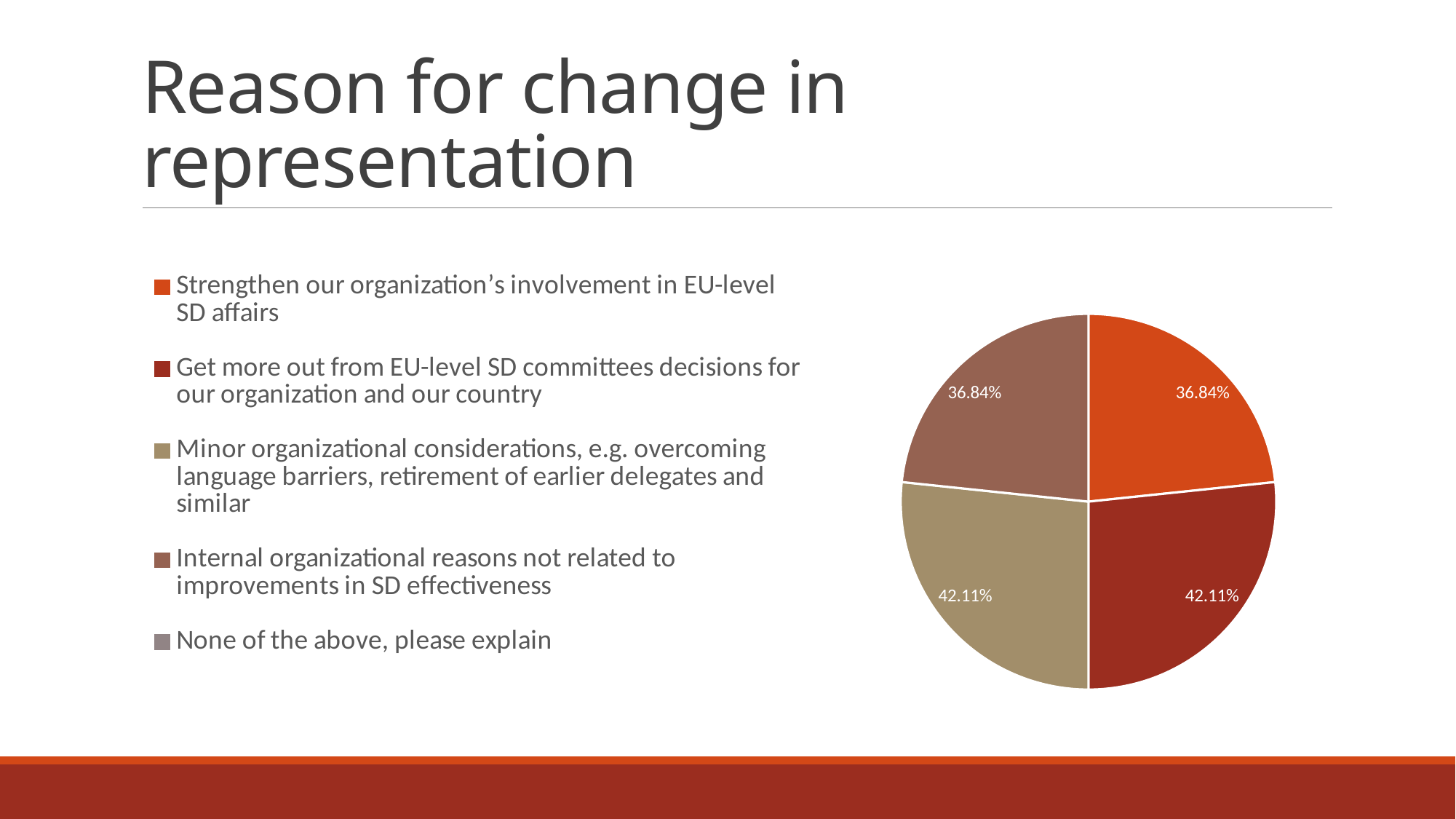
Which is larger: the value for "Get more out from EU-level SD committees decisions" or the value for "Strengthen our organization's involvement in EU-level SD affairs"? Get more out from EU-level SD committees decisions What is the title of the slide containing the pie chart? Reason for change in representation How many slices are visible in the pie chart? 4 How many entries does the legend list? 5 What percentage is shown for "Strengthen our organization's involvement in EU-level SD affairs"? 36.84% Which legend entry is shown in orange? Strengthen our organization's involvement in EU-level SD affairs What percentage is shown for "Internal organizational reasons not related to improvements in SD effectiveness"? 36.84% What kind of chart is shown on the slide? pie chart What percentage is shown for "Get more out from EU-level SD committees decisions for our organization and our country"? 42.11% What percentage is shown for "Minor organizational considerations, e.g. overcoming language barriers, retirement of earlier delegates and similar"? 42.11% What is the difference between the value for "Minor organizational considerations" and the value for "Internal organizational reasons"? 5.27%